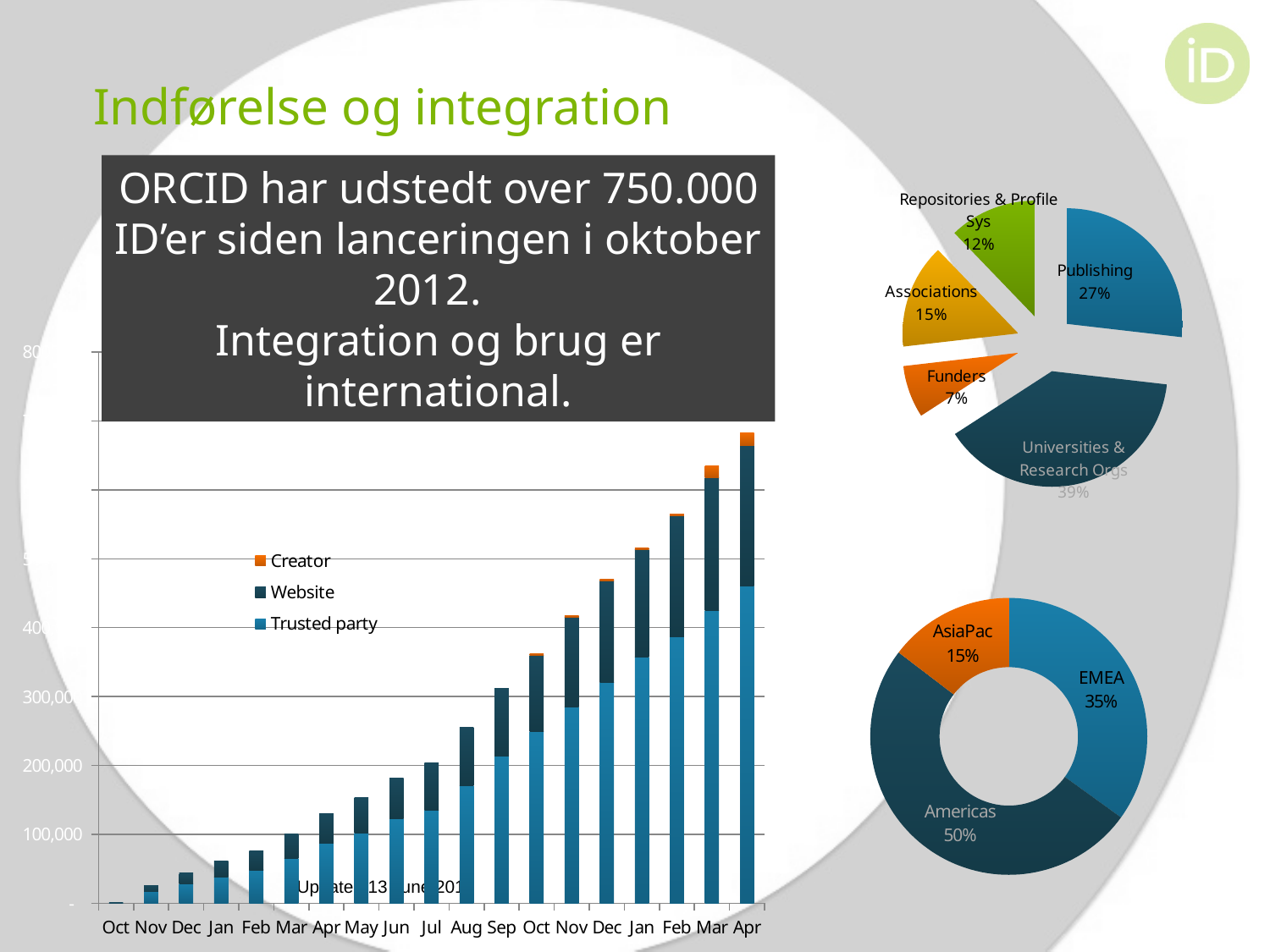
In the bar chart at the bottom left, is the total for the last Apr bar greater or less than 600,000? greater What kind of chart is the chart at the bottom left of the slide? Stacked bar chart In the pie chart at the top right, what share does Publishing have? 27% In the doughnut chart at the bottom right, which region has the smallest share? AsiaPac How many series does the legend of the bar chart at the bottom left list? 3 In the pie chart at the top right, which category has the largest share? Universities & Research Orgs In the doughnut chart at the bottom right, what share do the Americas have? 50% In the pie chart at the top right, which category has the smallest share? Funders How many slices does the pie chart at the top right have? 5 In the doughnut chart at the bottom right, what is the difference in percentage points between EMEA and AsiaPac? 20 In the pie chart at the top right, what is the difference in percentage points between Publishing and Associations? 12 In the doughnut chart at the bottom right, which is larger, EMEA or AsiaPac? EMEA